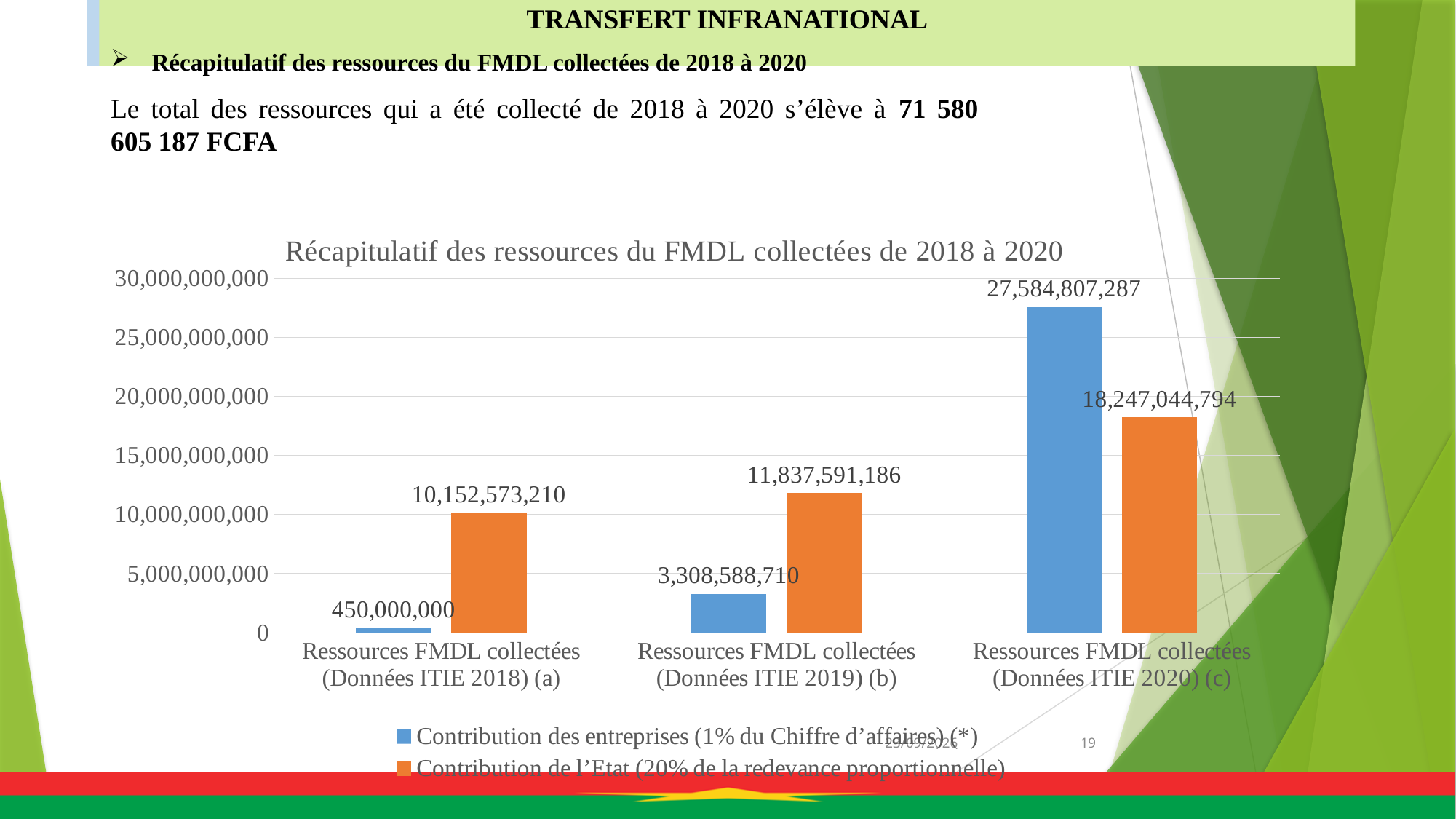
Which category has the lowest value for the Contribution de l'Etat series? Ressources FMDL collectées (Données ITIE 2018) (a) What is the value of the Contribution de l'Etat for Ressources FMDL collectées (Données ITIE 2019) (b)? 11,837,591,186 What is the difference between the Contribution des entreprises and the Contribution de l'Etat for Ressources FMDL collectées (Données ITIE 2020) (c)? 9,337,762,493 How many categories are shown on the x axis of the chart? 3 What is the value of the Contribution de l'Etat for Ressources FMDL collectées (Données ITIE 2018) (a)? 10,152,573,210 For Ressources FMDL collectées (Données ITIE 2019) (b), which is larger: the Contribution des entreprises or the Contribution de l'Etat? Contribution de l'Etat Which category has the highest value for the Contribution des entreprises series? Ressources FMDL collectées (Données ITIE 2020) (c) How many series does the chart legend list? 2 What type of chart is shown on the slide? Bar chart What is the value of the Contribution des entreprises for Ressources FMDL collectées (Données ITIE 2018) (a)? 450,000,000 What is the value of the Contribution des entreprises for Ressources FMDL collectées (Données ITIE 2020) (c)? 27,584,807,287 Does the Contribution de l'Etat rise or fall from 2018 to 2020 along the x axis? Rise